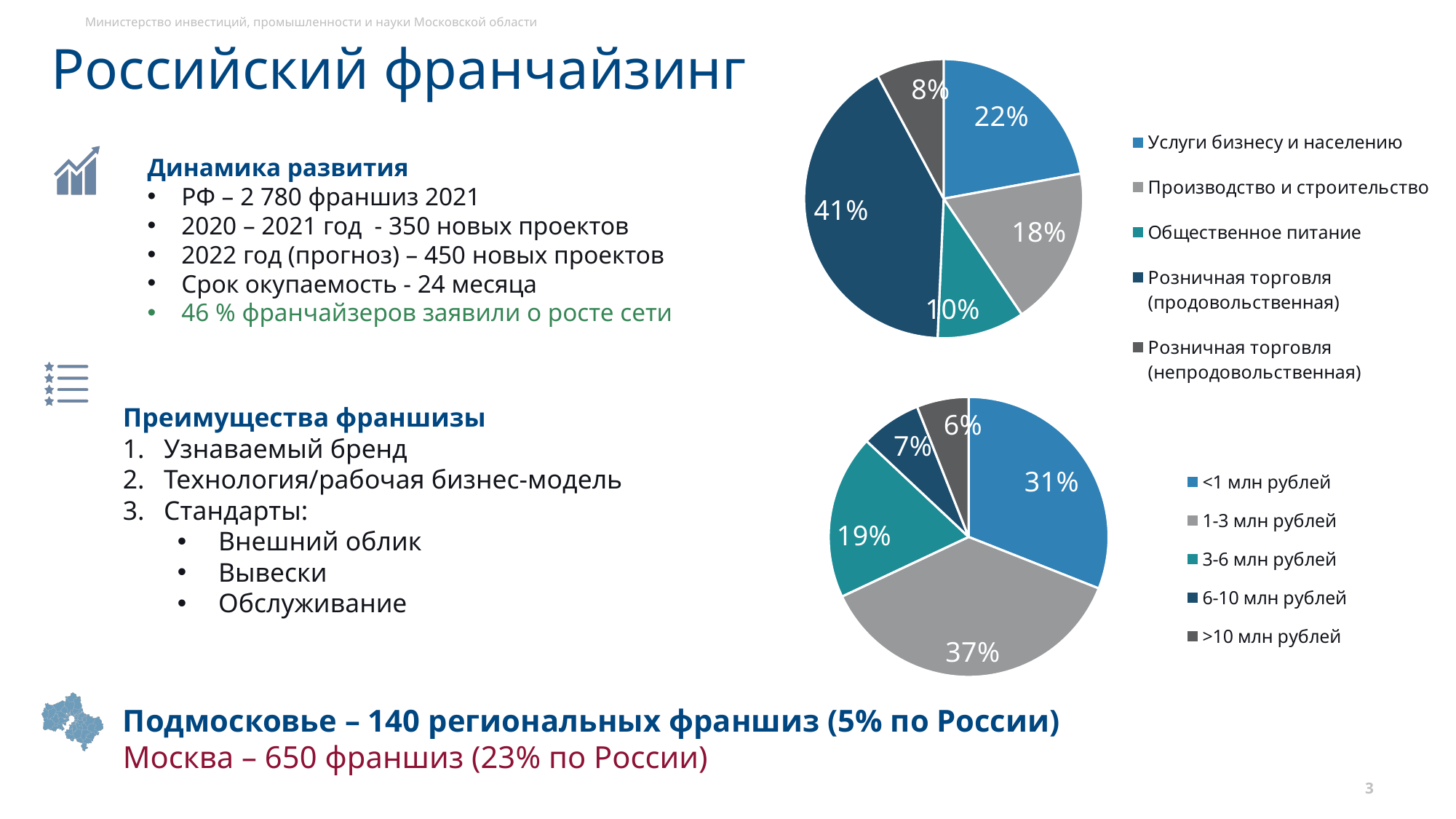
In the bottom pie chart, what is the difference between the shares of 3-6 млн рублей and >10 млн рублей? 13% How many categories does the legend of the top pie chart list? 5 In the top pie chart, what is the difference between the shares of Услуги бизнесу и населению and Производство и строительство? 4% In the top pie chart, which category has the smallest share? Розничная торговля (непродовольственная) In the top pie chart, what share does Розничная торговля (продовольственная) have? 41% In the bottom pie chart, what share does 6-10 млн рублей have? 7% In the bottom pie chart, what share does 1-3 млн рублей have? 37% In the top pie chart, which category has the largest share? Розничная торговля (продовольственная) In the bottom pie chart, which is larger: the share for <1 млн рублей or the share for 3-6 млн рублей? <1 млн рублей What type of chart is the bottom chart on the slide? Pie chart In the bottom pie chart, which category has the largest share? 1-3 млн рублей In the top pie chart, what share does Общественное питание have? 10%